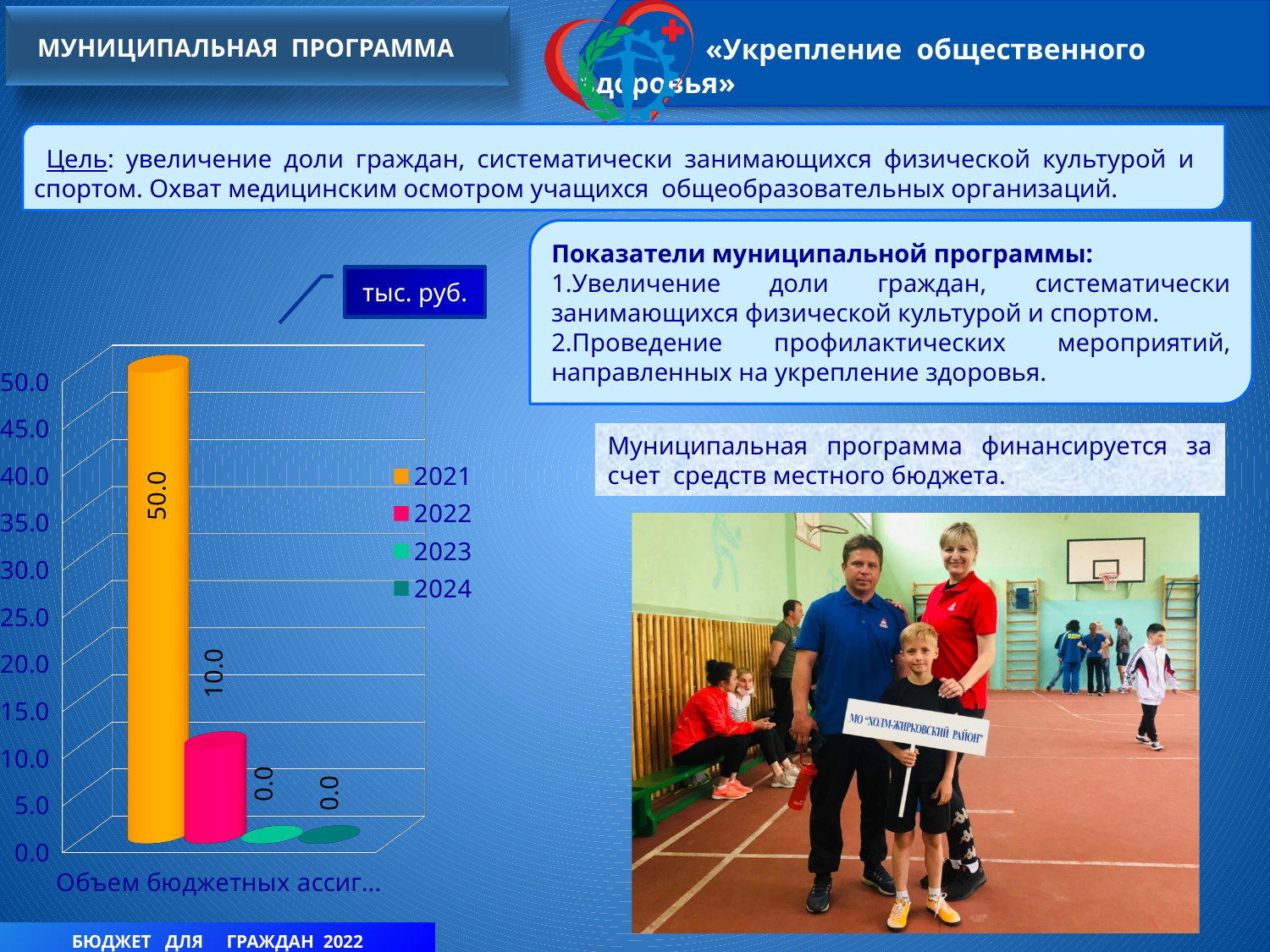
How many series does the chart legend list? 4 Which is larger, the value for 2021 or the value for 2022? 2021 Do the values rise or fall from 2021 to 2024? fall What is the value for 2022 in the chart? 10.0 What unit is indicated in the box above the chart? тыс. руб. Which year has the highest value in the chart? 2021 What is the value for 2023 in the chart? 0.0 What is the value for 2021 in the chart? 50.0 Is the value for 2022 greater or less than 20.0? less What is the difference between the values for 2021 and 2022? 40.0 What is the value for 2024 in the chart? 0.0 What kind of chart is shown on the slide? bar chart